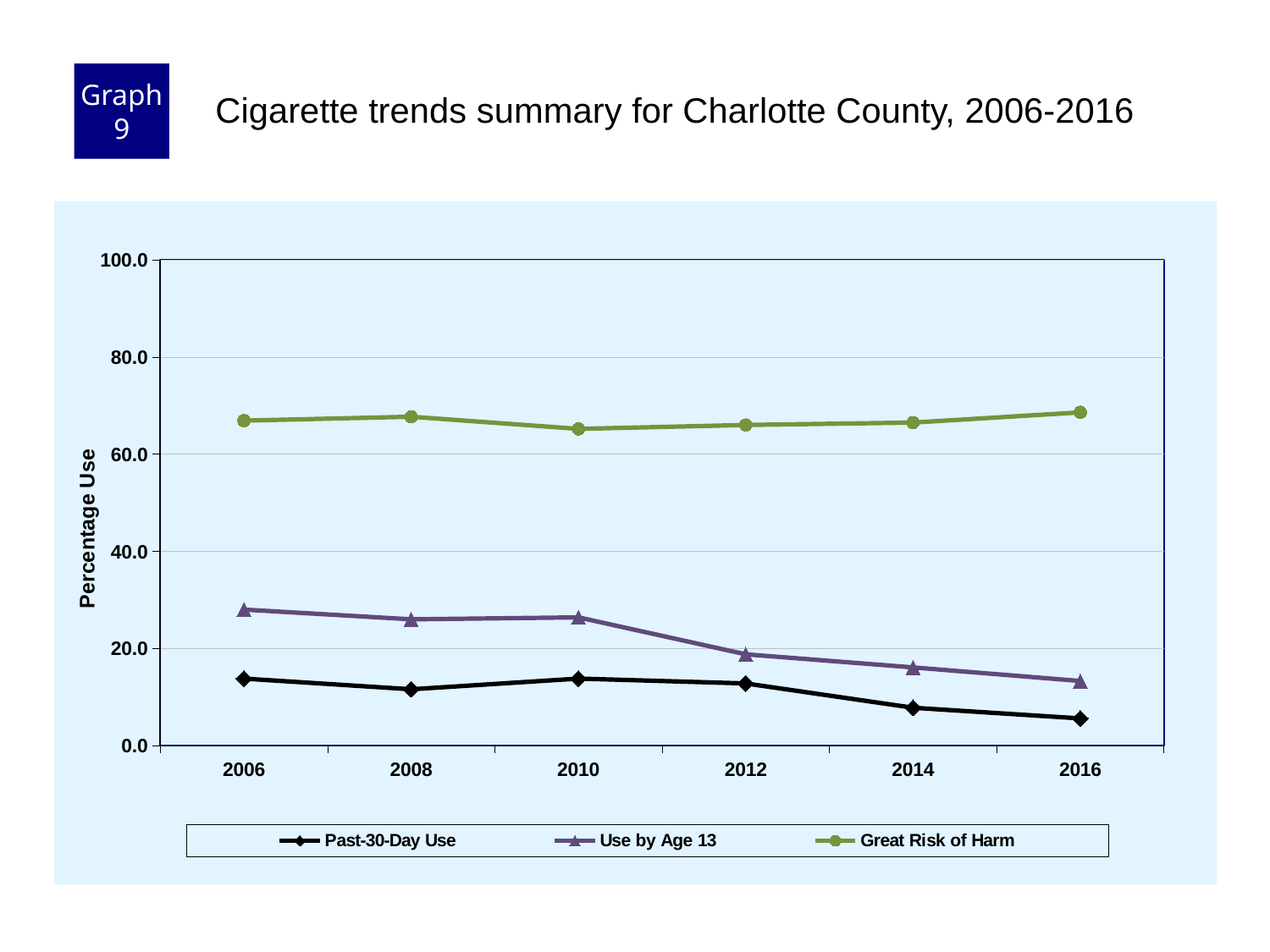
Which series has the highest values across all years? Great Risk of Harm What is the label on the y axis? Percentage Use Is the value for Great Risk of Harm in 2010 greater or less than 80.0? less In 2012, which is larger: Great Risk of Harm or Past-30-Day Use? Great Risk of Harm In which year is Past-30-Day Use at its lowest? 2016 Is the value for Great Risk of Harm in 2006 greater or less than 60.0? greater What kind of chart is shown on the slide? Line chart Does Use by Age 13 rise or fall from 2006 to 2016? Fall How many years are plotted along the x axis? 6 Is the value for Past-30-Day Use in 2016 greater or less than 20.0? less How many series does the legend list? 3